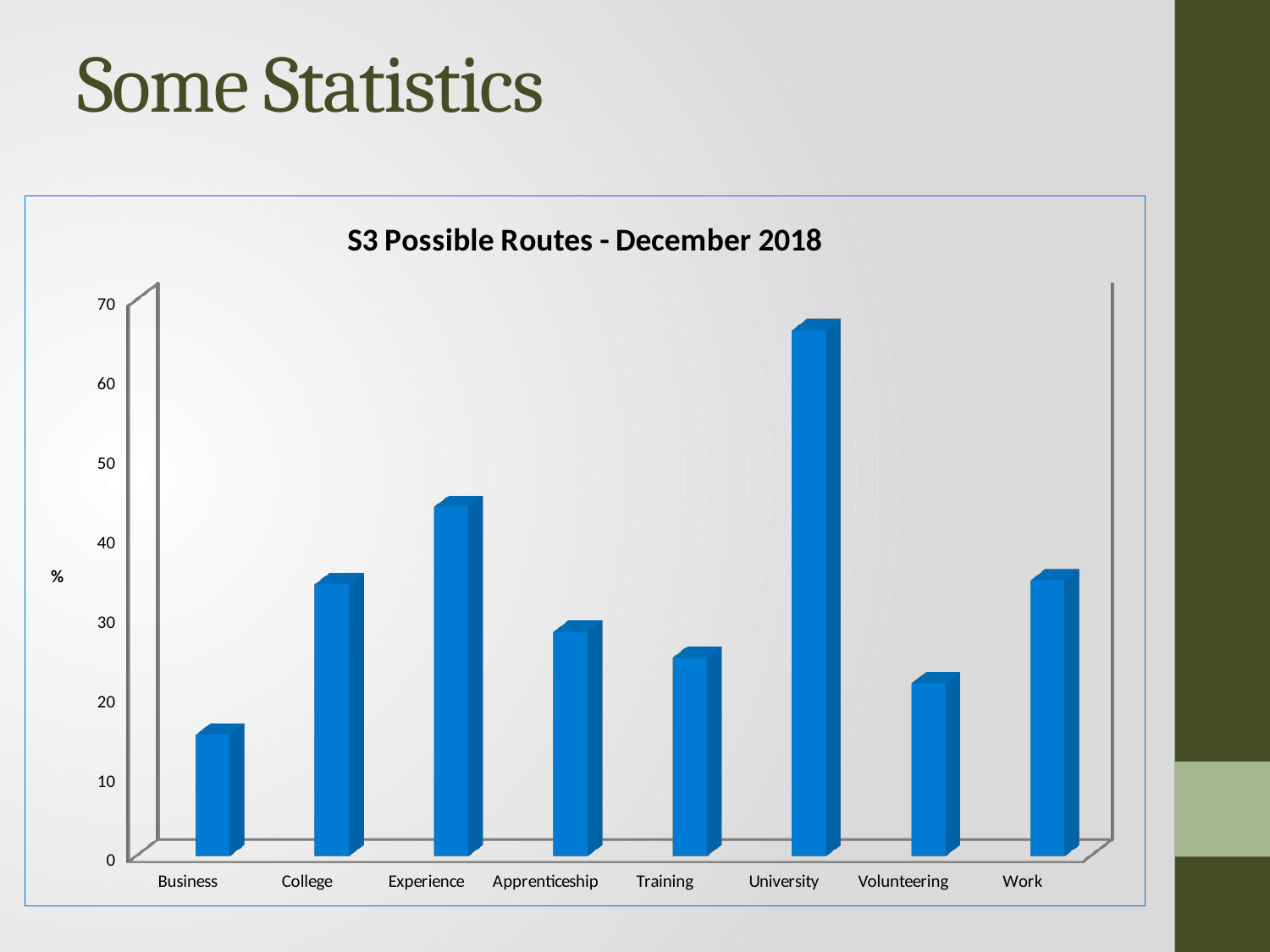
Which category has the lowest value in the chart? Business How many categories are shown on the x axis of the chart? 8 Is the value for University greater or less than 60? greater Is the value for College greater or less than 30? greater What is the title of the chart? S3 Possible Routes - December 2018 What type of chart is shown on the slide? bar chart Which is larger, the value for Experience or the value for Volunteering? Experience What label is shown on the vertical axis of the chart? % Is the value for Business greater or less than 20? less Which category has the highest value in the chart? University